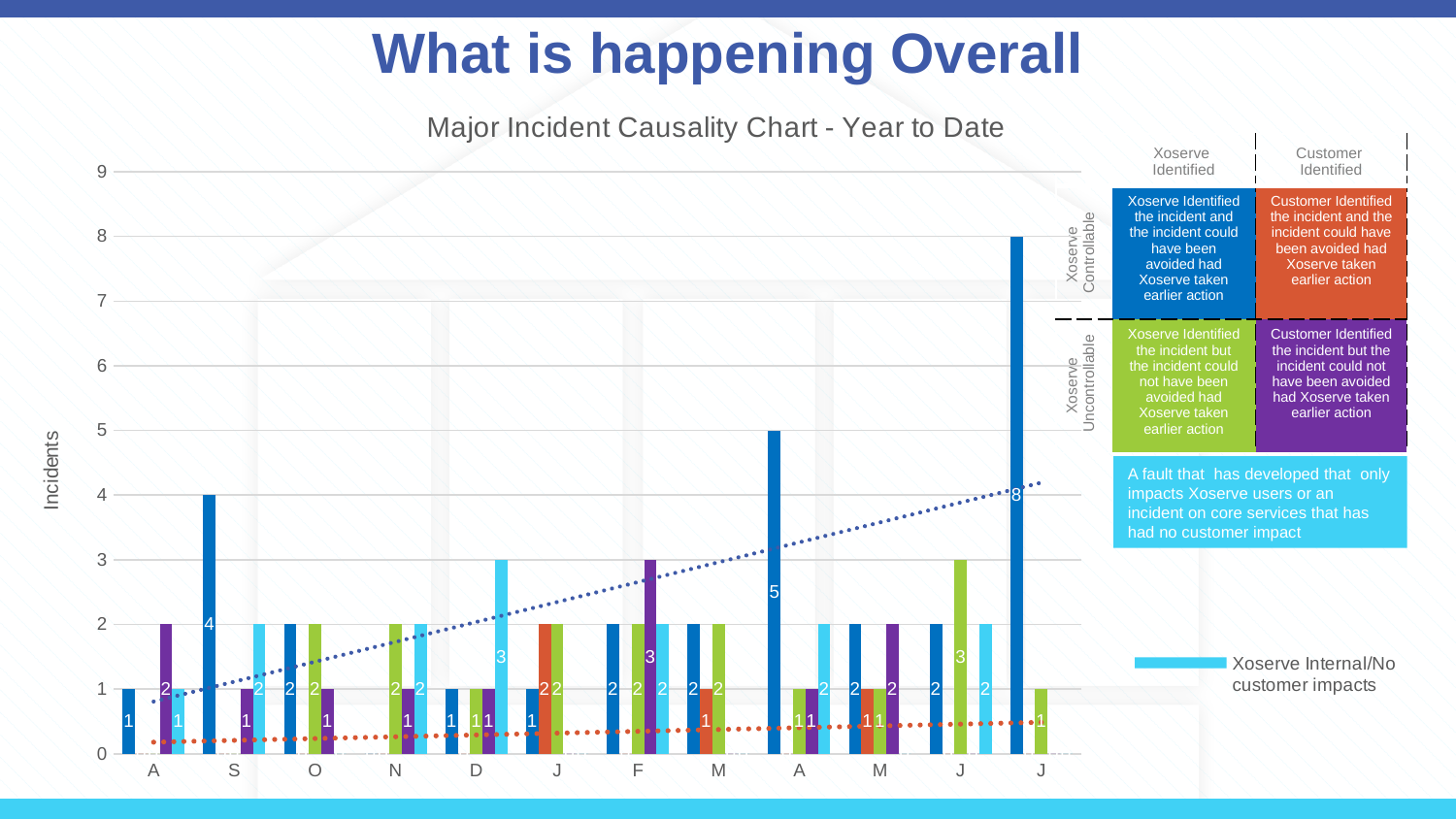
What is the value of the dark blue bar in the S month group? 4 How many month labels are shown along the x axis? 12 Does the dotted blue trend line rise or fall from left to right? rise What kind of chart is shown on the slide? bar chart What is the title of the chart? Major Incident Causality Chart - Year to Date Is the bar labelled 5 taller or shorter than the bar labelled 8? shorter What legend entry is shown for the light blue bars? Xoserve Internal/No customer impacts What is the highest value labelled on any bar in the chart? 8 Is the value of the tallest bar greater or less than 7? greater What is the highest tick value shown on the y axis? 9 What is the difference between the bar labelled 8 and the bar labelled 5? 3 What is the value of the tallest dark blue bar in the chart? 8